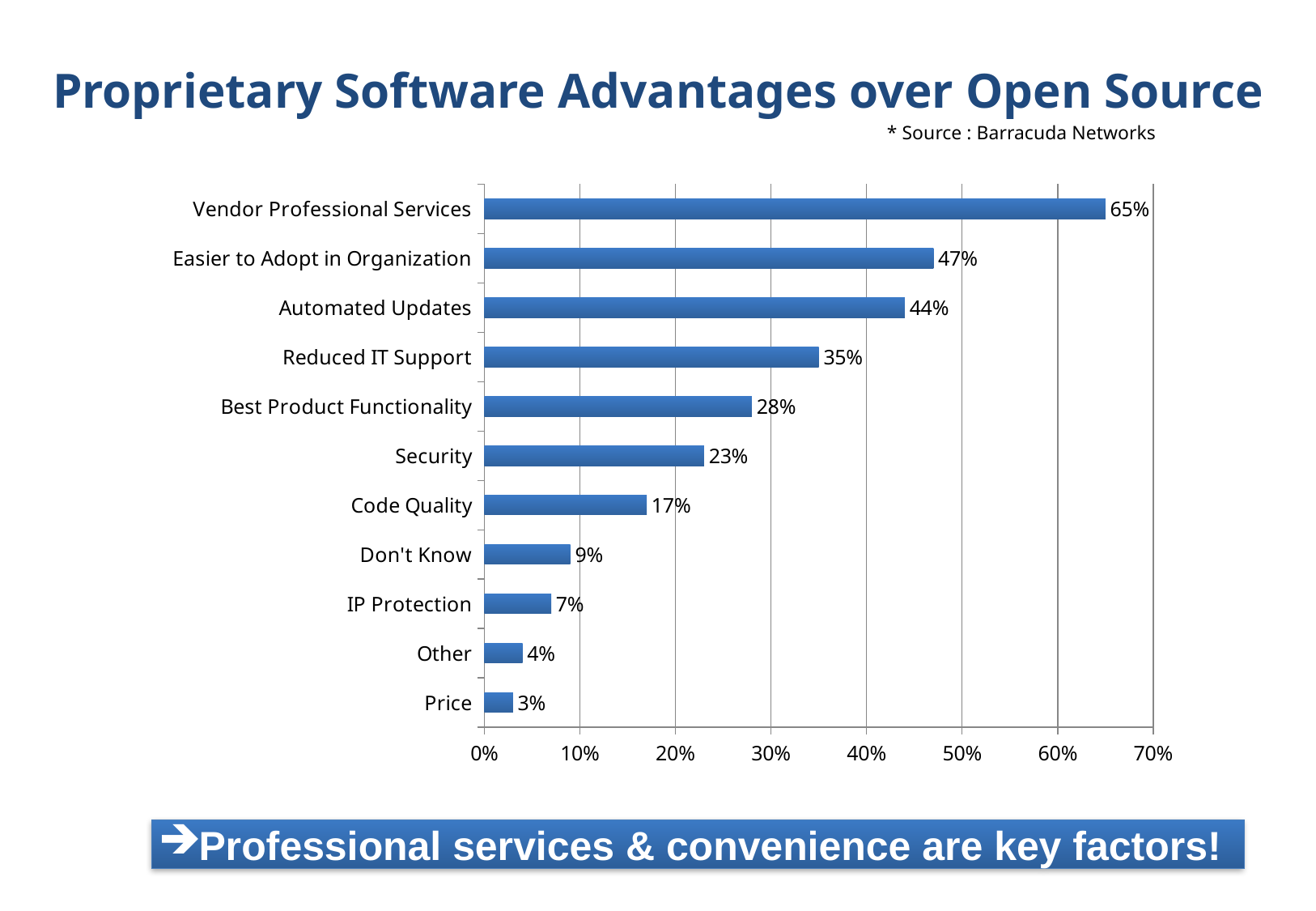
What is the source cited for the chart? Barracuda Networks What is the difference between Easier to Adopt in Organization and Automated Updates? 3% Which category has the lowest value? Price What is the value for Security? 23% Which category has the highest value? Vendor Professional Services What is the difference between Vendor Professional Services and Reduced IT Support? 30% What kind of chart is shown on the slide? Bar chart Which is larger, Code Quality or Best Product Functionality? Best Product Functionality Is the value for Reduced IT Support greater or less than 30%? greater How many categories are shown in the chart? 11 What is the value for Vendor Professional Services? 65% What is the value for Automated Updates? 44%